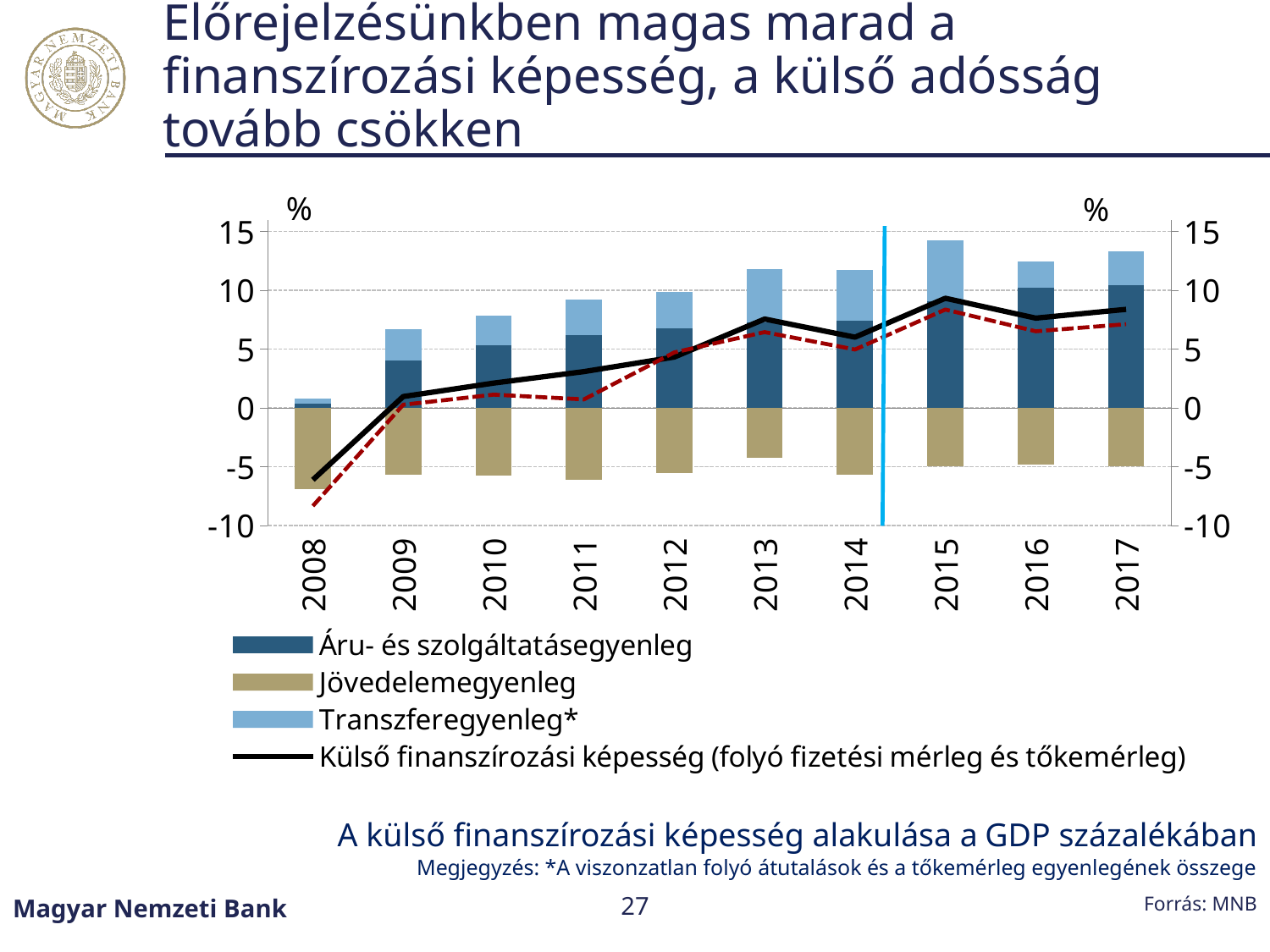
In which year is the Jövedelemegyenleg bar segment the most negative? 2008 How many years are shown on the x axis of the chart? 10 Is the Áru- és szolgáltatásegyenleg segment in 2017 greater or less than 5? greater In which year is the Külső finanszírozási képesség line at its lowest? 2008 In which year is the Áru- és szolgáltatásegyenleg bar segment the smallest? 2008 Is the value of the Külső finanszírozási képesség line in 2015 greater or less than 5? greater How many series does the chart's legend list? 4 Does the Külső finanszírozási képesség line rise or fall between 2008 and 2013? rise Is the value of the Külső finanszírozási képesség line in 2008 greater or less than 0? less What unit is shown on the vertical axes of the chart? % What kind of chart is shown on the slide? A stacked bar chart combined with a line In which year is the Külső finanszírozási képesség line at its highest? 2015